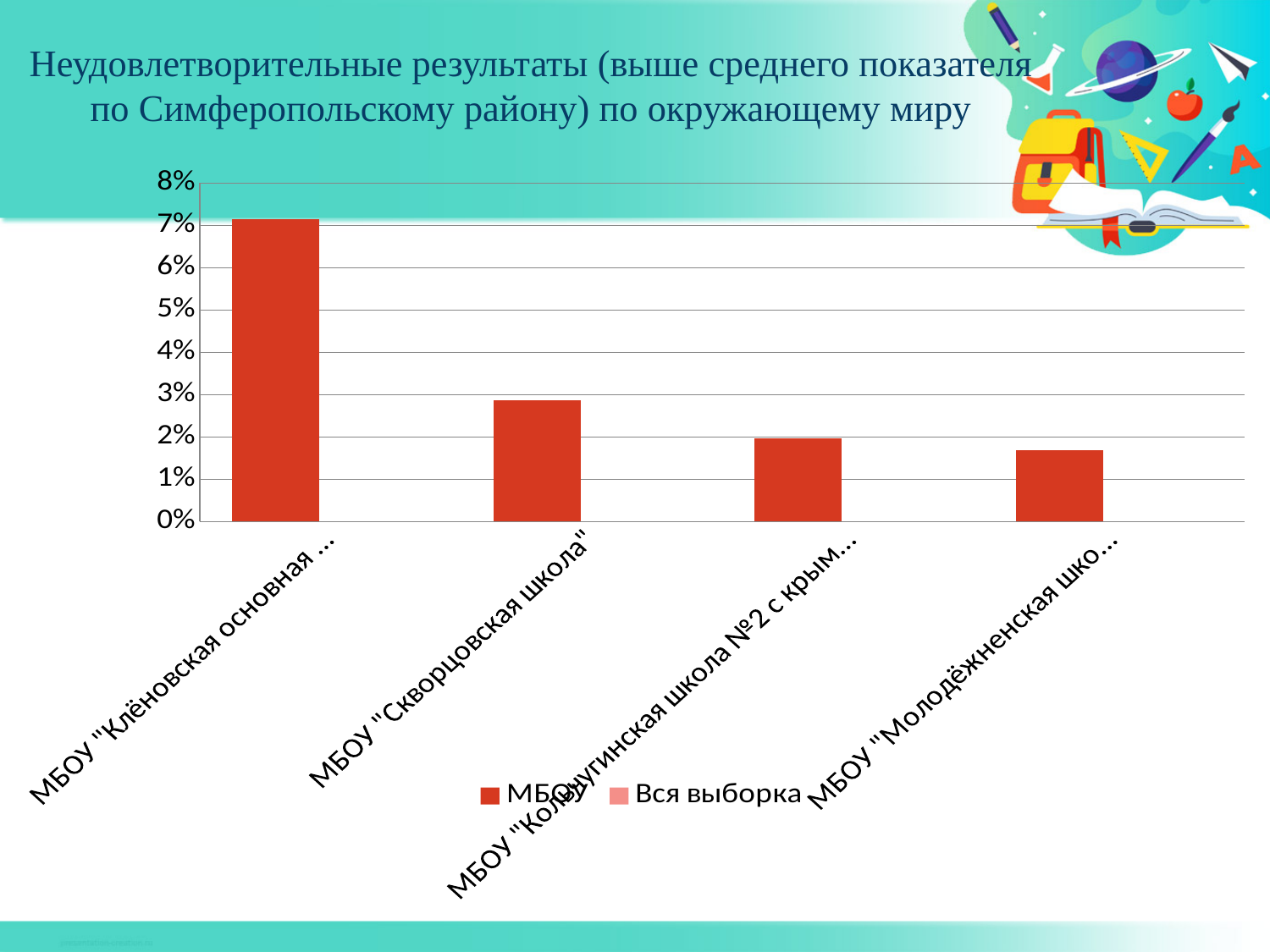
Is the value for МБОУ "Скворцовская школа" greater or less than 2%? greater What are the two entries listed in the chart legend? МБОУ and Вся выборка Is the value for МБОУ "Скворцовская школа" greater or less than 3%? less Do the bar values rise or fall from left to right along the x axis? fall Is the value for МБОУ "Молодёжненская шко…" greater or less than 2%? less How many series does the legend list? 2 Which school has the lowest bar on the chart? МБОУ "Молодёжненская шко…" Which is larger, the value for МБОУ "Скворцовская школа" or the value for МБОУ "Кольчугинская школа №2 с крым…"? МБОУ "Скворцовская школа" Which school has the highest bar on the chart? МБОУ "Клёновская основная …" How many schools (categories) are plotted on the chart? 4 What kind of chart is shown on the slide? bar chart